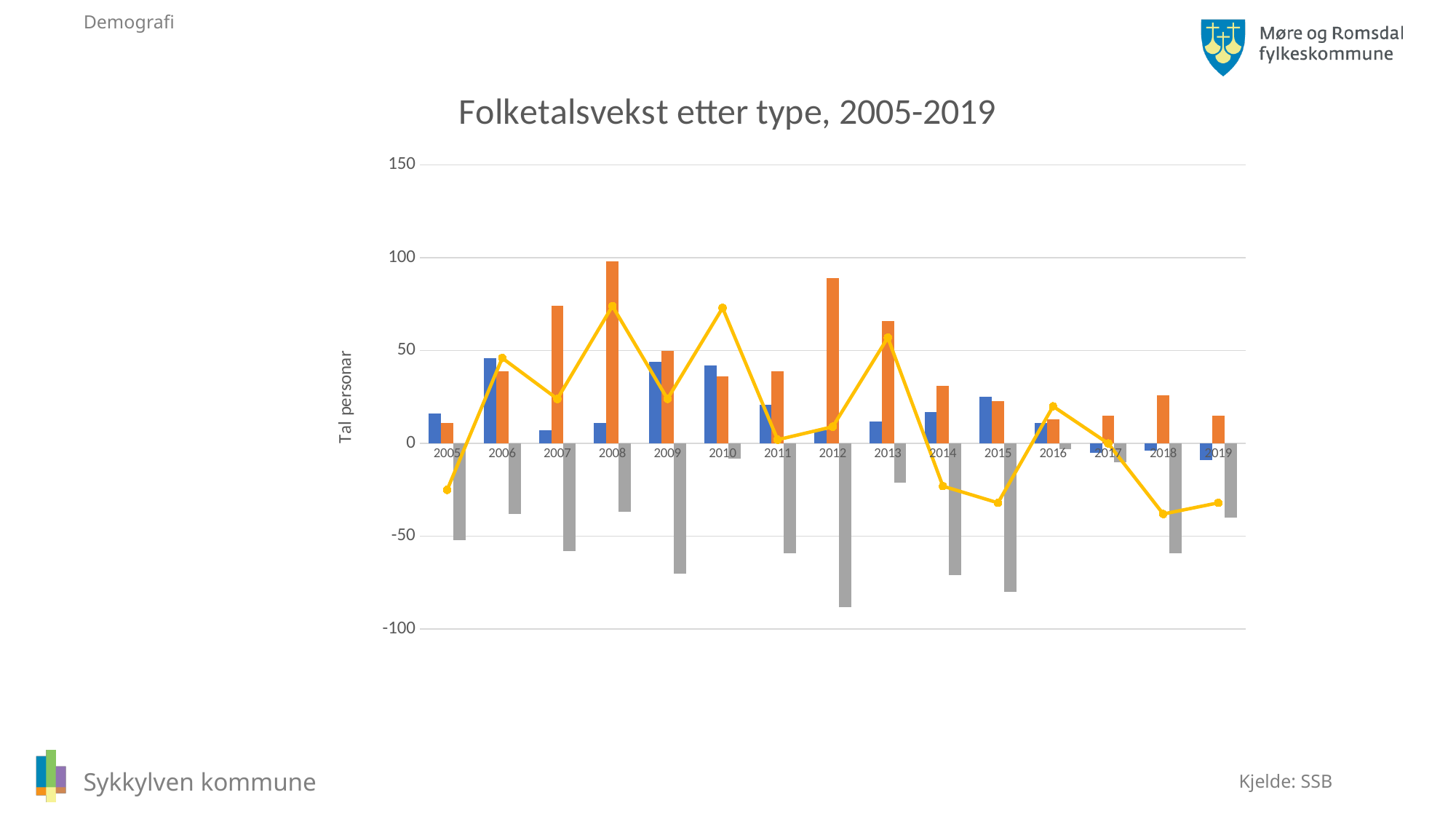
Which year has the larger orange bar, 2007 or 2008? 2008 What is the label on the vertical axis of the chart? Tal personar In which year is the grey bar lowest (most negative)? 2012 In which year is the orange bar highest? 2008 Is the value of the grey bar for 2012 greater or less than -50? less What is the title of the chart? Folketalsvekst etter type, 2005-2019 Is the value of the yellow line for 2010 greater or less than 50? greater What kind of chart is shown on the slide? Combined bar and line chart Which year has the larger blue bar, 2005 or 2007? 2005 Is the value of the orange bar for 2008 greater or less than 50? greater How many years are shown along the x axis of the chart? 15